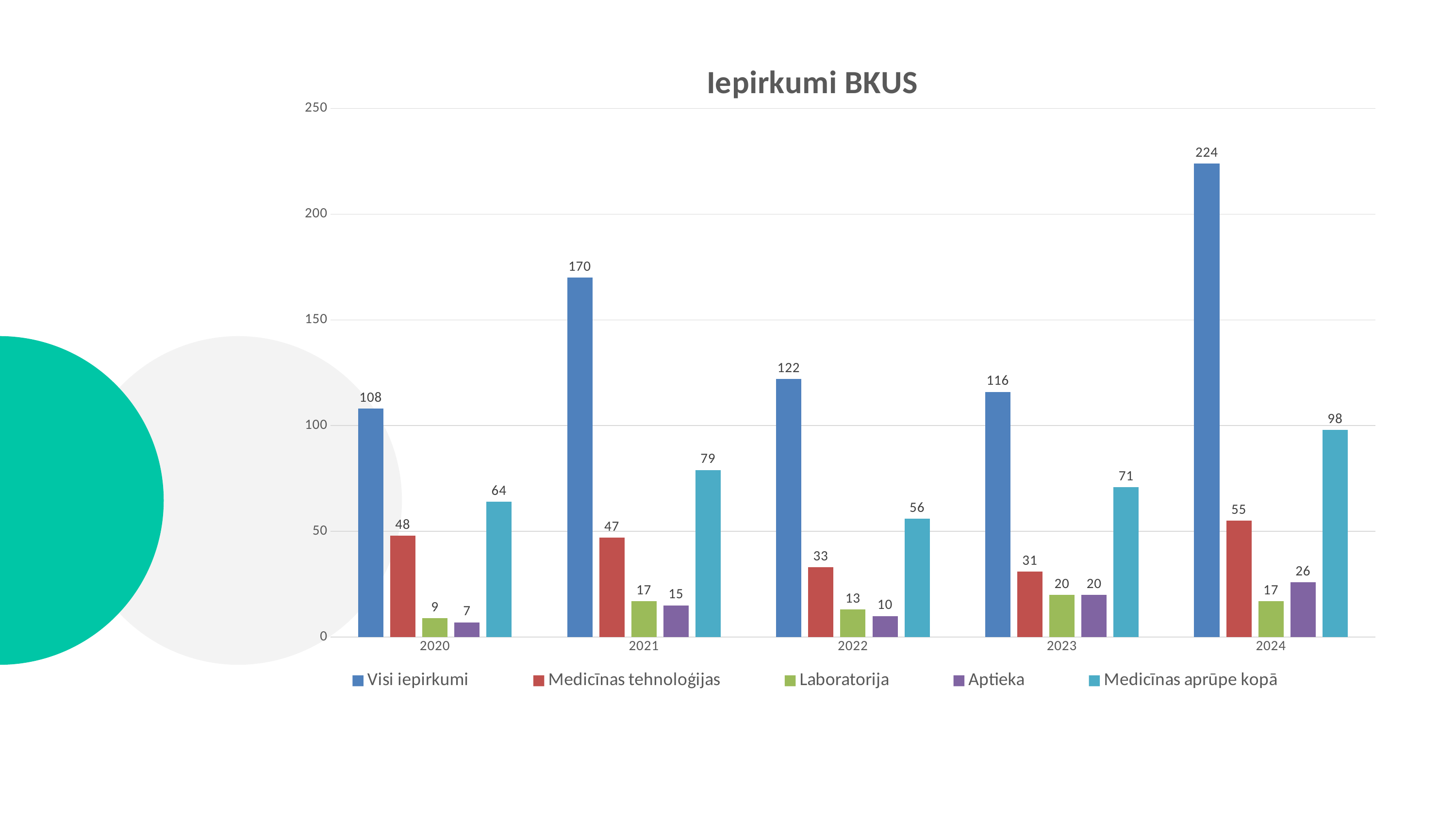
What is the value for Aptieka in 2020? 7 What is the difference between Visi iepirkumi in 2024 and in 2023? 108 In which year is Visi iepirkumi highest? 2024 What kind of chart is shown? Bar chart What is the value for Visi iepirkumi in 2024? 224 In which year is Laboratorija lowest? 2020 How many series does the legend list? 5 Which is larger in 2022: Laboratorija or Aptieka? Laboratorija What is the value for Medicīnas tehnoloģijas in 2021? 47 What is the value for Medicīnas aprūpe kopā in 2023? 71 What is the title of the chart? Iepirkumi BKUS How many years are shown on the x axis? 5